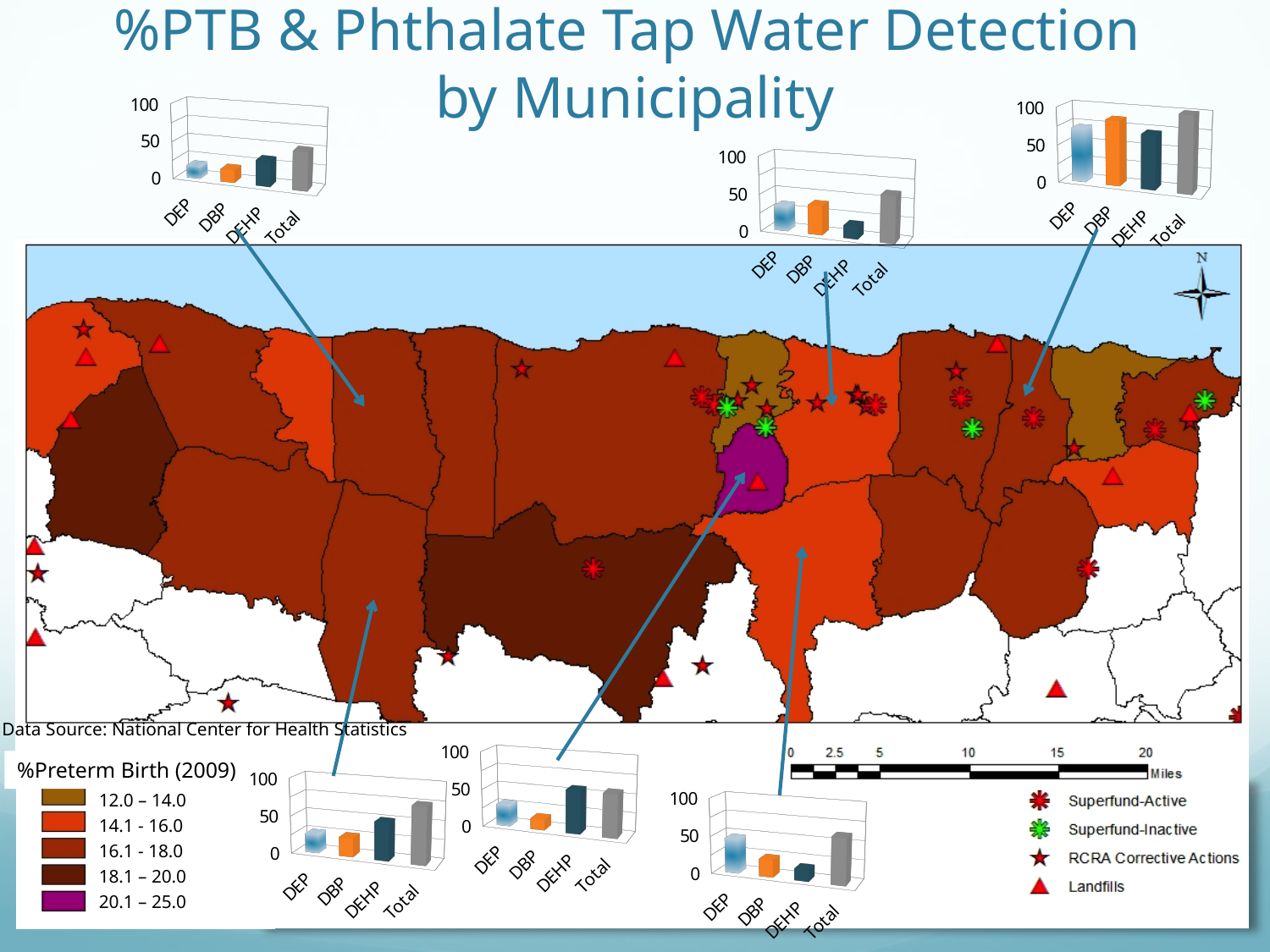
In the top-middle chart (above the map, right of centre), which category has the lowest bar? DEHP In the bottom-left chart, which category has the highest bar? Total In the bottom-right chart, which is larger, the value for DEP or the value for DBP? DEP In the top-right chart, is the value for DBP greater or less than 50? greater In the bottom-middle chart (pointing to the purple municipality), which category has the lowest bar? DBP What kind of chart is the top-left chart on the slide? bar chart What is the title of the slide containing the charts? %PTB & Phthalate Tap Water Detection by Municipality How many categories are shown on the x axis of the top-right chart? 4 In the top-right chart, which category has the highest bar? Total In the top-left chart, which category has the highest bar? Total